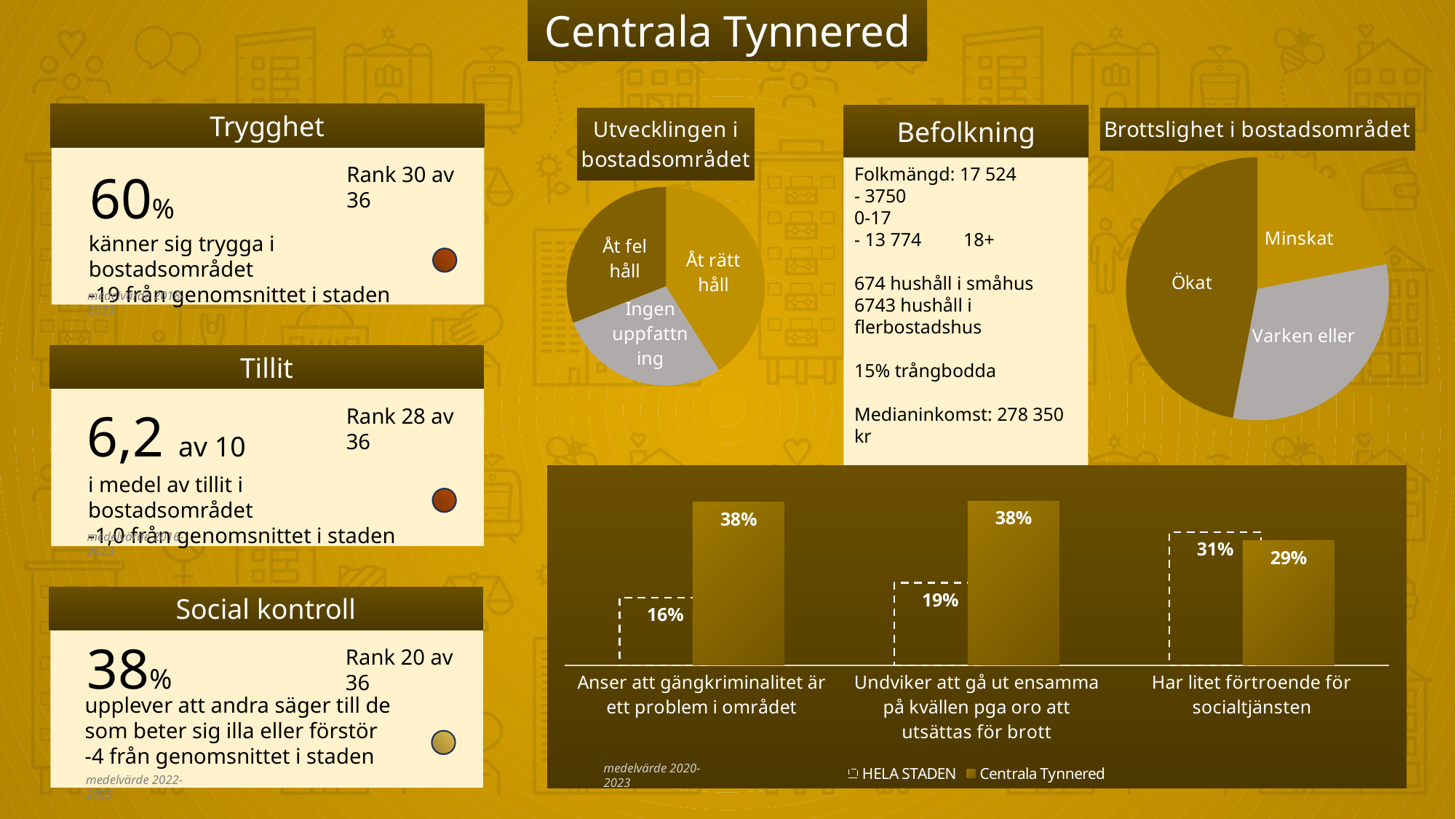
In the bar chart at the bottom of the slide, what is the value for Centrala Tynnered for 'Anser att gängkriminalitet är ett problem i området'? 38% In the bar chart at the bottom of the slide, what is the value for Centrala Tynnered for 'Har litet förtroende för socialtjänsten'? 29% How many slices does the 'Utvecklingen i bostadsområdet' pie chart have? 3 In the 'Brottslighet i bostadsområdet' pie chart, which slice is the largest? Ökat What kind of chart is 'Brottslighet i bostadsområdet'? Pie chart In the bar chart at the bottom of the slide, what is the value for HELA STADEN for 'Undviker att gå ut ensamma på kvällen pga oro att utsättas för brott'? 19% In the bar chart at the bottom of the slide, what is the difference between HELA STADEN and Centrala Tynnered for 'Har litet förtroende för socialtjänsten'? 2% In the bar chart at the bottom of the slide, which is larger for 'Har litet förtroende för socialtjänsten': HELA STADEN or Centrala Tynnered? HELA STADEN In the bar chart at the bottom of the slide, how many categories are shown? 3 In the bar chart at the bottom of the slide, how many series does the legend list? 2 In the bar chart at the bottom of the slide, what is the difference between Centrala Tynnered and HELA STADEN for 'Anser att gängkriminalitet är ett problem i området'? 22% In the bar chart at the bottom of the slide, which category has the lowest HELA STADEN value? Anser att gängkriminalitet är ett problem i området